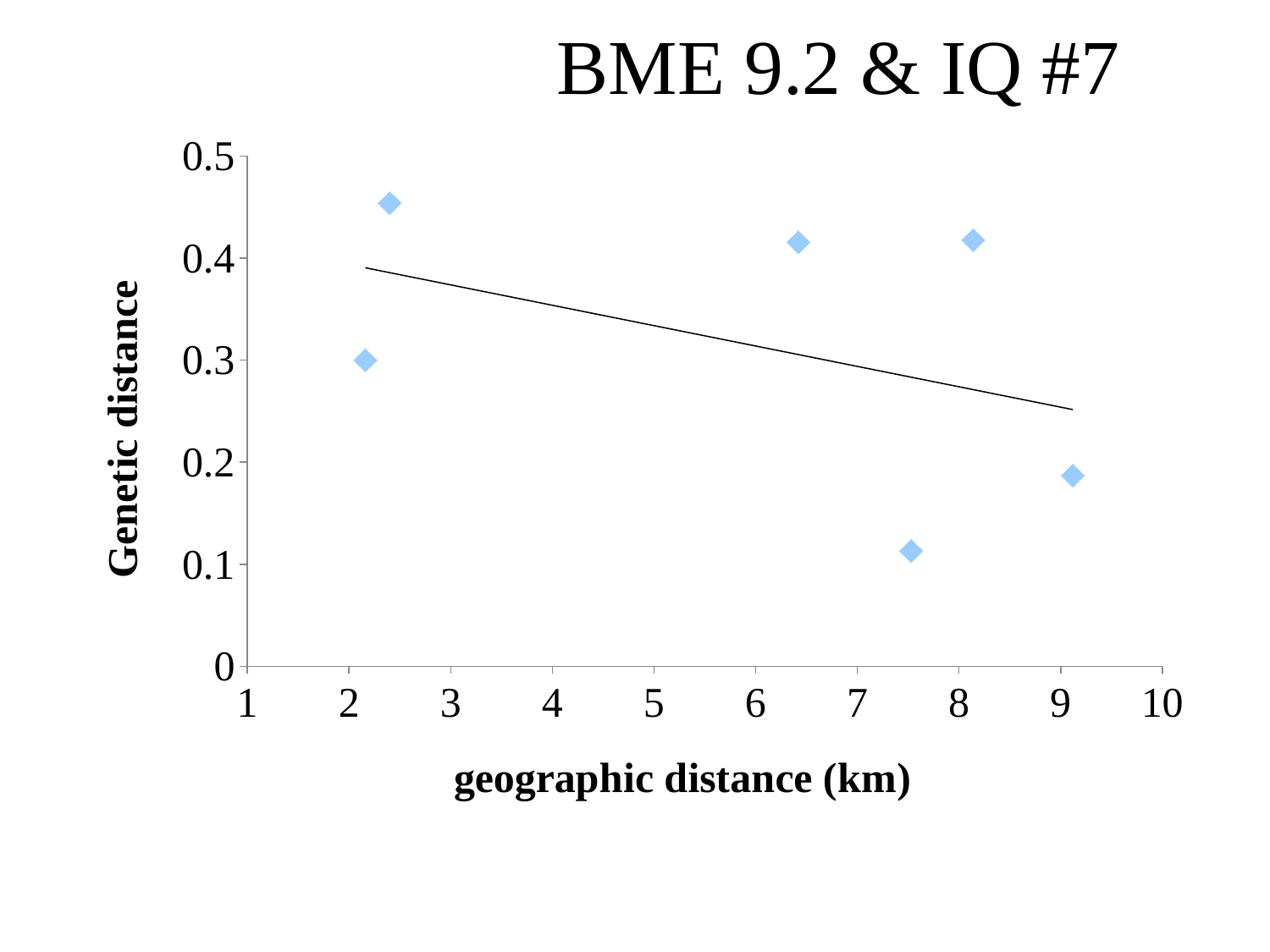
Which point has the lowest genetic distance: the one at about 7.5 km or the one at about 9.1 km? the one at about 7.5 km What is the label of the x axis? geographic distance (km) How many data points are plotted on the chart? 6 Does the fitted trend line rise or fall as geographic distance increases? fall What kind of chart is shown on the slide? scatter plot What is the title of the chart? BME 9.2 & IQ #7 What is the highest value shown on the y axis? 0.5 Is the genetic distance of the point at about 6.4 km greater or less than 0.3? greater Is the genetic distance of the point at about 7.5 km greater or less than 0.2? less Is the genetic distance of the point at about 9.1 km greater or less than 0.3? less Which has the larger genetic distance: the point at about 6.4 km or the point at about 7.5 km? the point at about 6.4 km